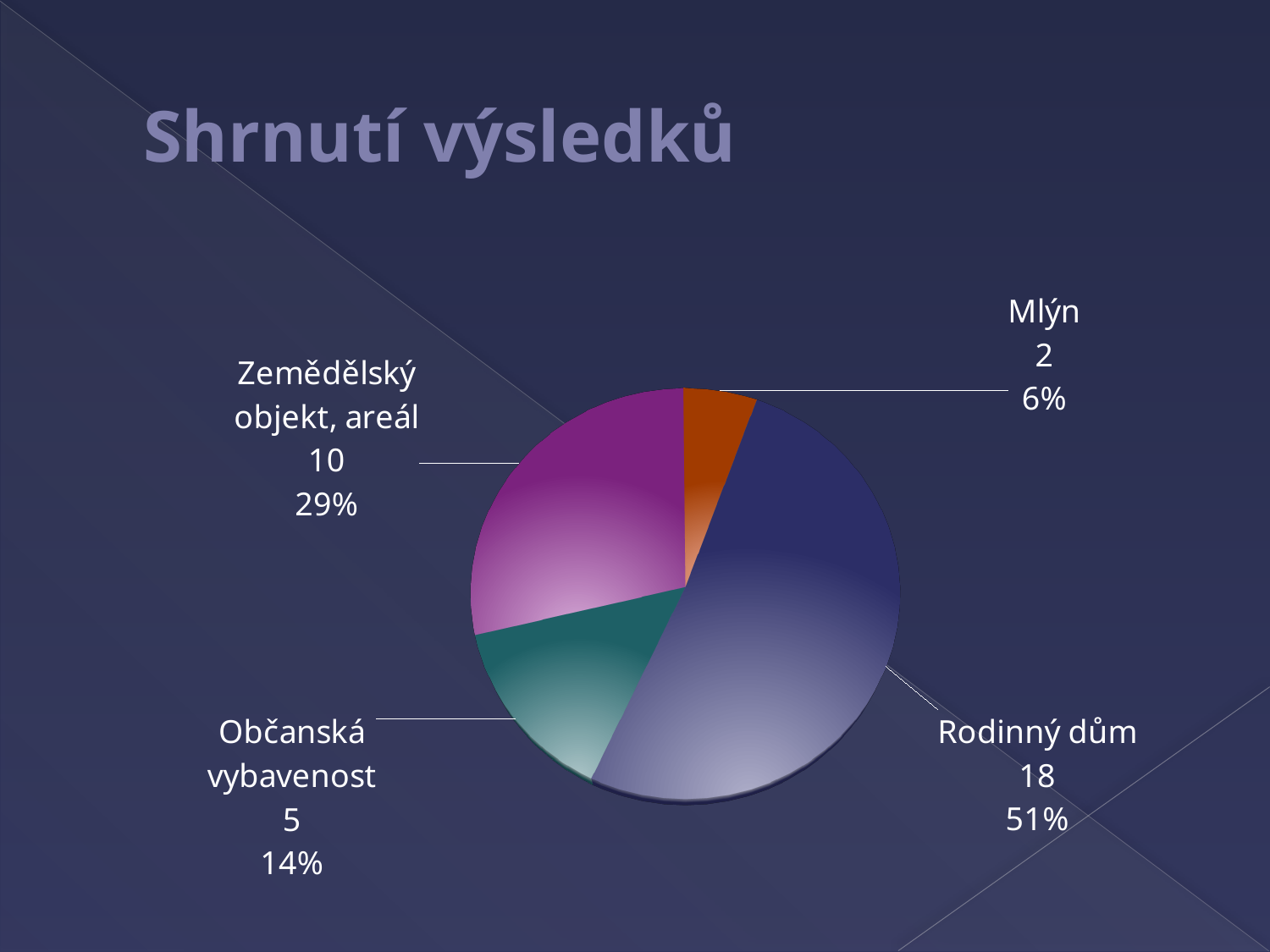
What share of the pie does Mlýn represent? 6% Which category has the largest slice? Rodinný dům What share of the pie does Rodinný dům represent? 51% Which category has the smallest slice? Mlýn What is the value for Občanská vybavenost? 5 What is the value for Rodinný dům? 18 How many slices does the pie chart have? 4 What is the value for Zemědělský objekt, areál? 10 What is the value for Mlýn? 2 What is the difference between the values for Rodinný dům and Zemědělský objekt, areál? 8 What kind of chart is shown on the slide? pie chart Which is larger, the value for Občanská vybavenost or the value for Mlýn? Občanská vybavenost